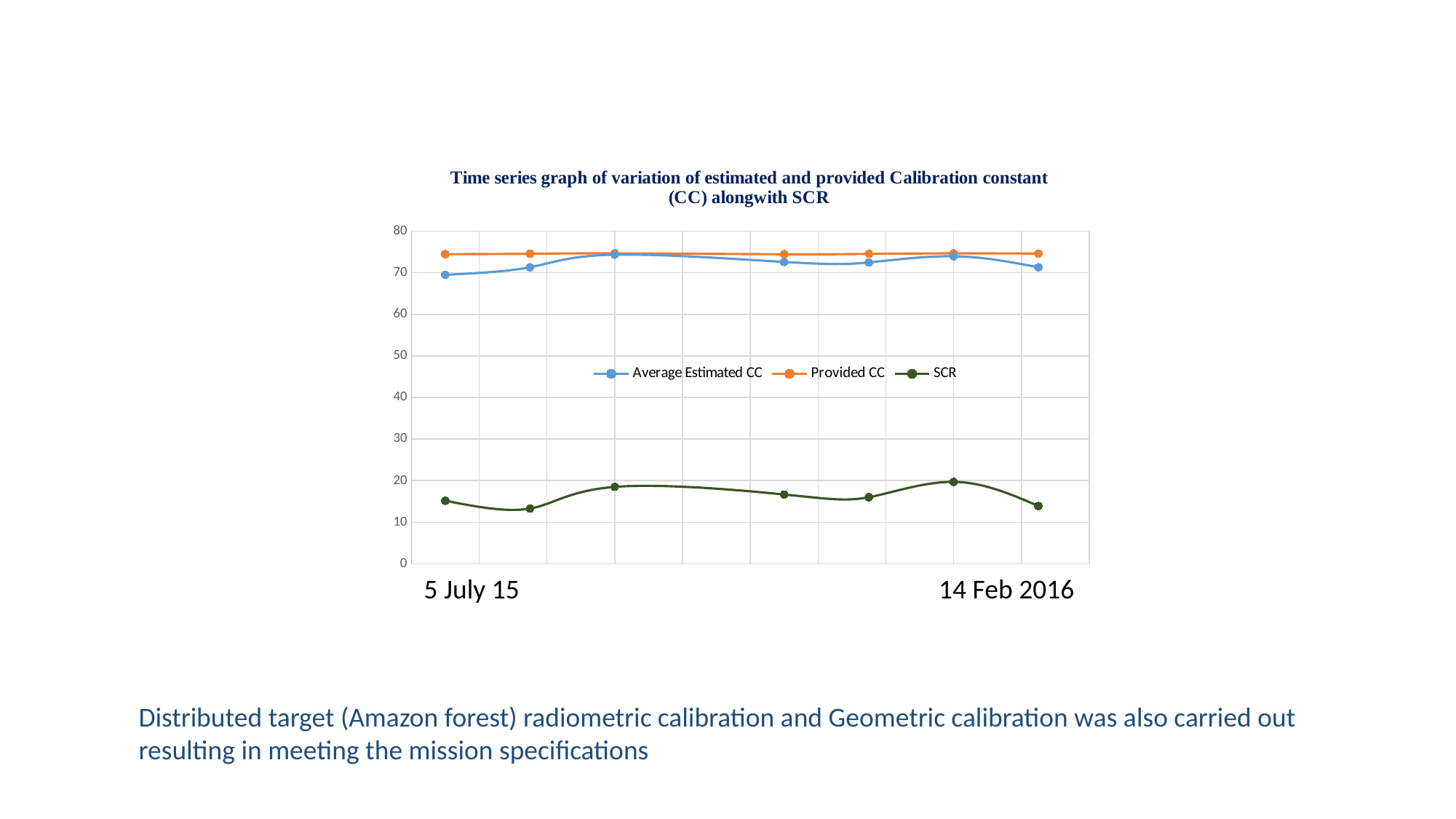
Which series is higher at 5 July 15, Average Estimated CC or SCR? Average Estimated CC Which series has the lowest values across the whole time series? SCR Is the SCR value at 14 Feb 2016 greater or less than 30? less Is the SCR value at 5 July 15 greater or less than 20? less What is the title of the chart? Time series graph of variation of estimated and provided Calibration constant (CC) alongwith SCR What kind of chart is shown on the slide? line chart How many series does the legend list? 3 Is the Average Estimated CC value at 5 July 15 greater or less than 60? greater How many data points are plotted for the SCR series? 7 Which series is higher at 14 Feb 2016, Provided CC or SCR? Provided CC Which series is drawn in orange? Provided CC